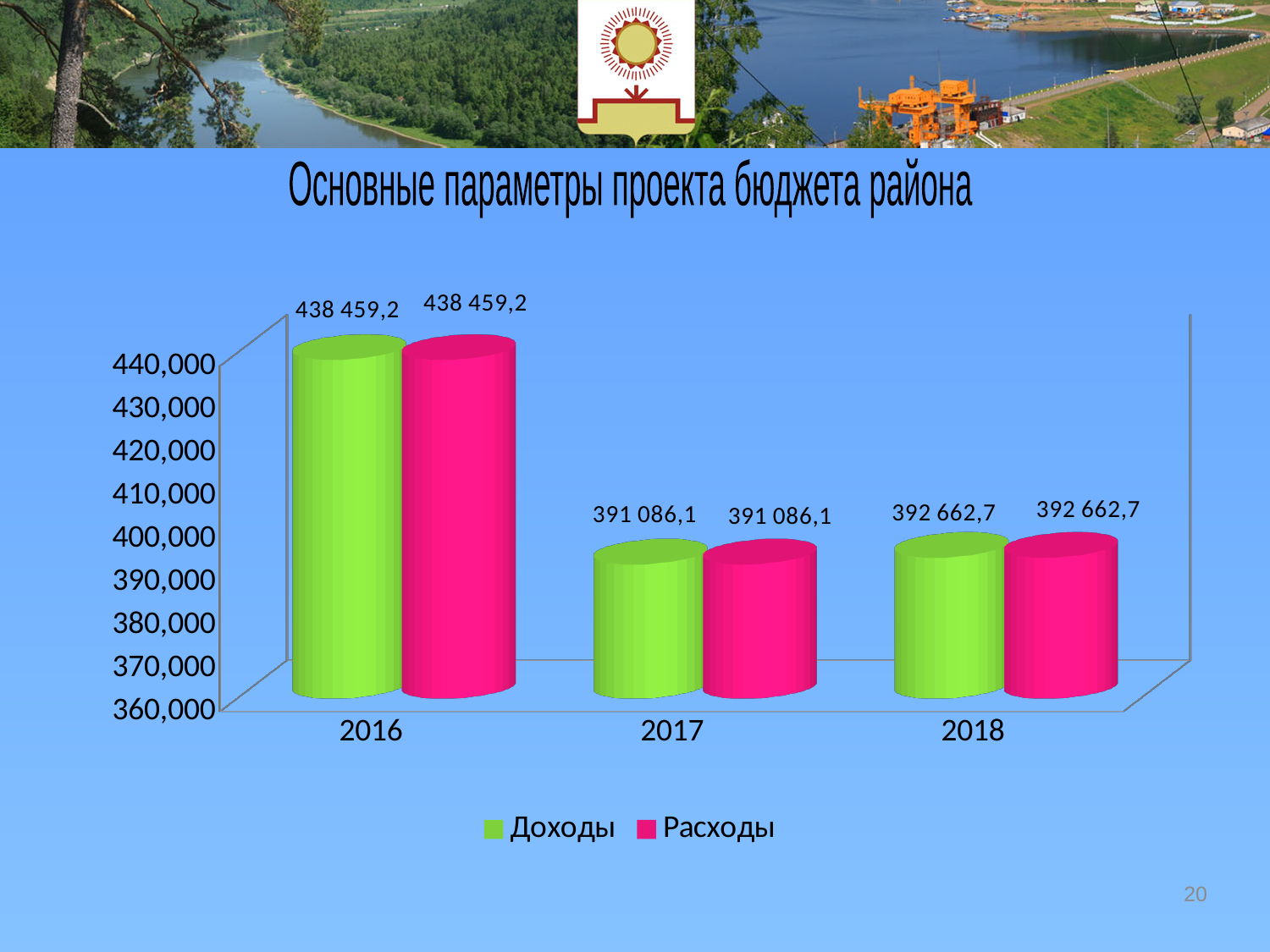
What is the value of Расходы for 2017? 391 086,1 How many series does the legend list? 2 Is the value of Расходы for 2017 greater or less than 400,000? less How many years are shown on the x axis? 3 What is the value of Доходы for 2018? 392 662,7 What is the difference between Расходы in 2018 and Расходы in 2017? 1 576,6 What is the difference between Доходы in 2016 and Доходы in 2017? 47 373,1 Which year has the lowest value of Расходы? 2017 Which year has the highest value of Доходы? 2016 What is the value of Доходы for 2016? 438 459,2 What kind of chart is shown on the slide? bar chart Which is larger: Доходы in 2016 or Доходы in 2018? Доходы in 2016